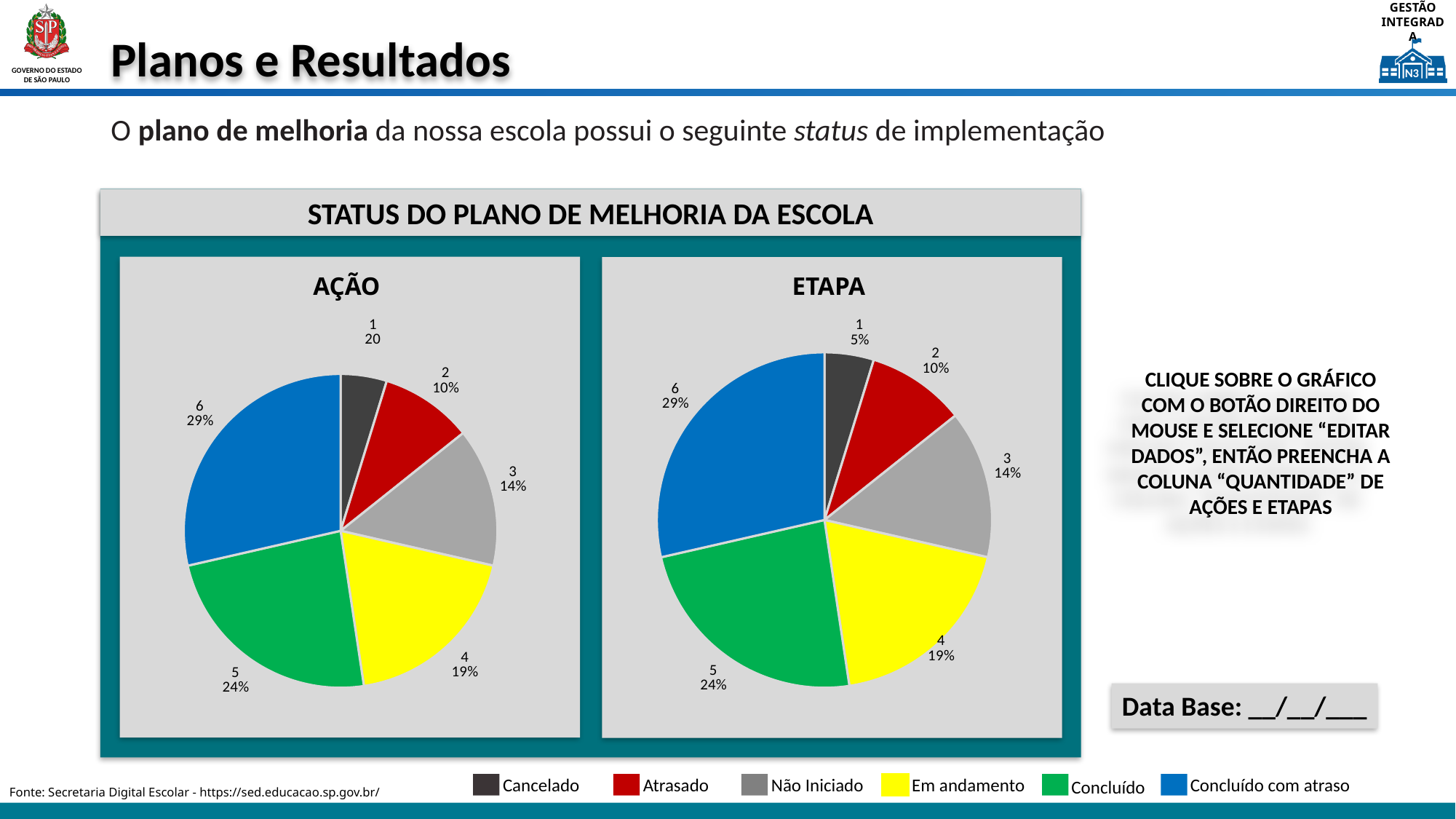
In the ETAPA chart, what percentage is shown for slice 6? 29% How many entries does the legend below the charts list? 6 In the AÇÃO chart, which is larger, slice 4 or slice 3? slice 4 What kind of chart is the AÇÃO chart? pie chart In the ETAPA chart, what percentage is shown for slice 1? 5% In the AÇÃO chart, what percentage is shown for slice 5? 24% In the AÇÃO chart, what value label is shown for slice 1? 20 In the ETAPA chart, which slice has the largest share? 6 How many slices does the ETAPA pie chart have? 6 In the ETAPA chart, which slice has the smallest share? 1 What is the title of the box containing both pie charts? STATUS DO PLANO DE MELHORIA DA ESCOLA In the ETAPA chart, what is the difference in percentage points between slice 6 and slice 2? 19